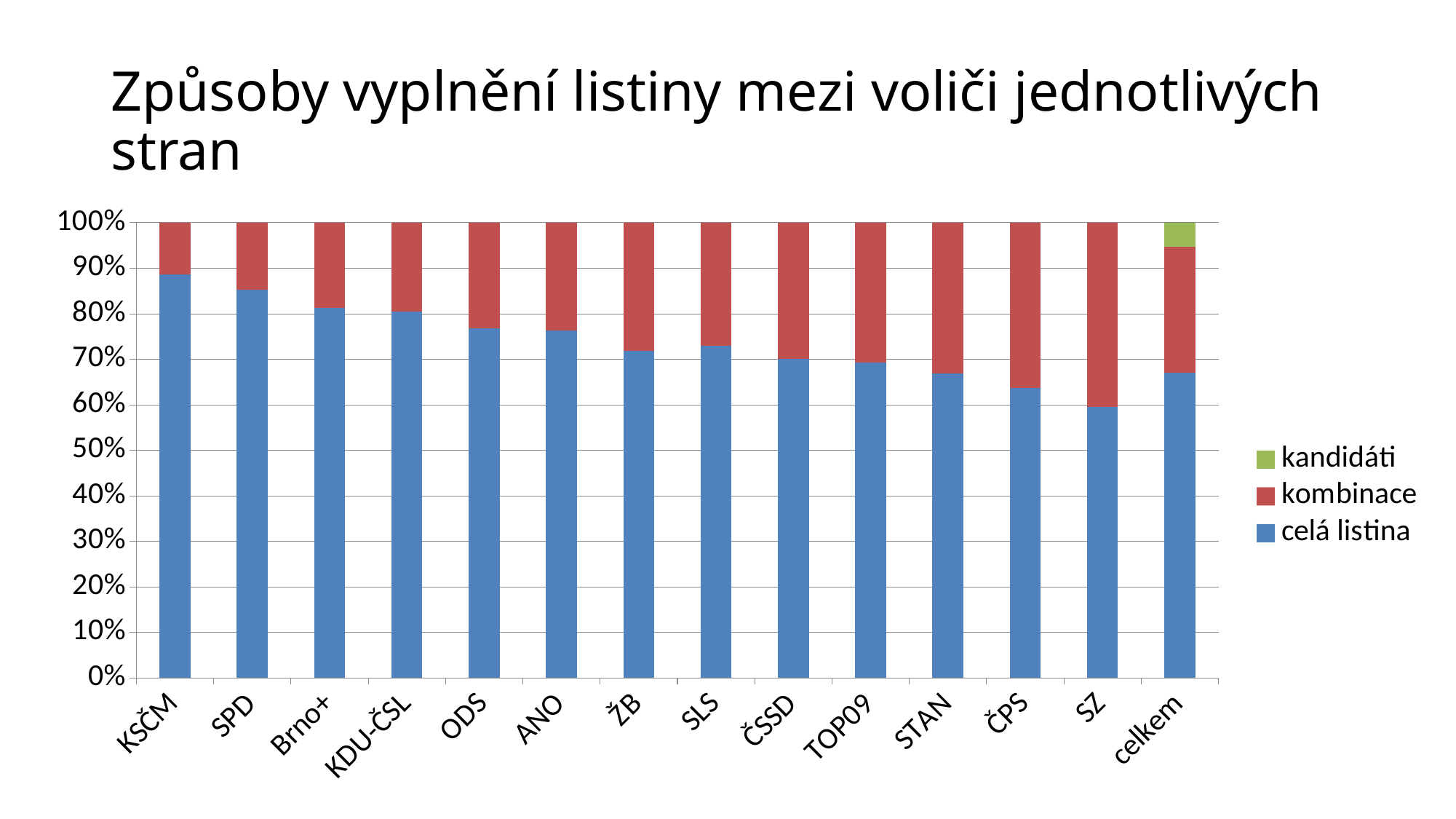
Is the 'celá listina' value for KSČM greater or less than 80%? greater Which category is the only one with a visible 'kandidáti' segment? celkem Does the 'celá listina' share generally rise or fall from KSČM to SZ along the x axis? fall What is the total height of each stacked bar? 100% Is the 'celá listina' value for SZ greater or less than 70%? less Which has a larger 'celá listina' share, SPD or ČPS? SPD Which category has the lowest share of 'celá listina'? SZ Which category has the highest share of 'celá listina'? KSČM How many series does the legend list? 3 How many categories are shown on the x axis? 14 Is the 'celá listina' value for ODS greater or less than 70%? greater What kind of chart is shown on the slide? stacked bar chart